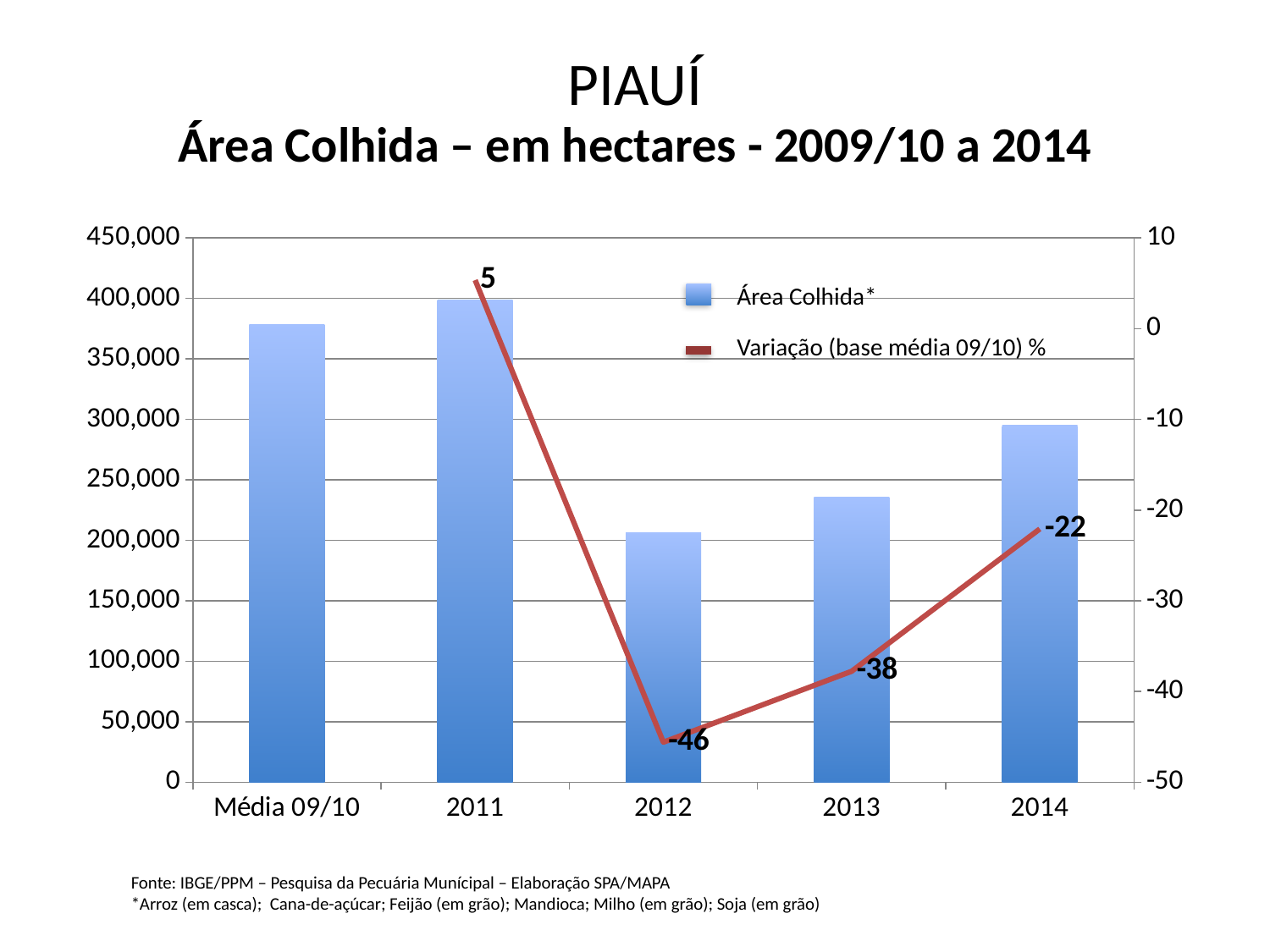
Is the Área Colhida value for Média 09/10 greater or less than 350,000? greater What is the value of Variação (base média 09/10) % for 2012? -46 Is the Área Colhida value for 2012 greater or less than 250,000? less What is the value of Variação (base média 09/10) % for 2011? 5 How many series does the legend list? 2 Which category has the shortest Área Colhida bar? 2012 Which year has the lowest Variação (base média 09/10) %? 2012 Which has the larger Área Colhida bar, 2013 or 2014? 2014 Which year has the highest Variação (base média 09/10) %? 2011 Which category has the tallest Área Colhida bar? 2011 What is the value of Variação (base média 09/10) % for 2014? -22 What is the difference between the Variação values for 2013 and 2012? 8